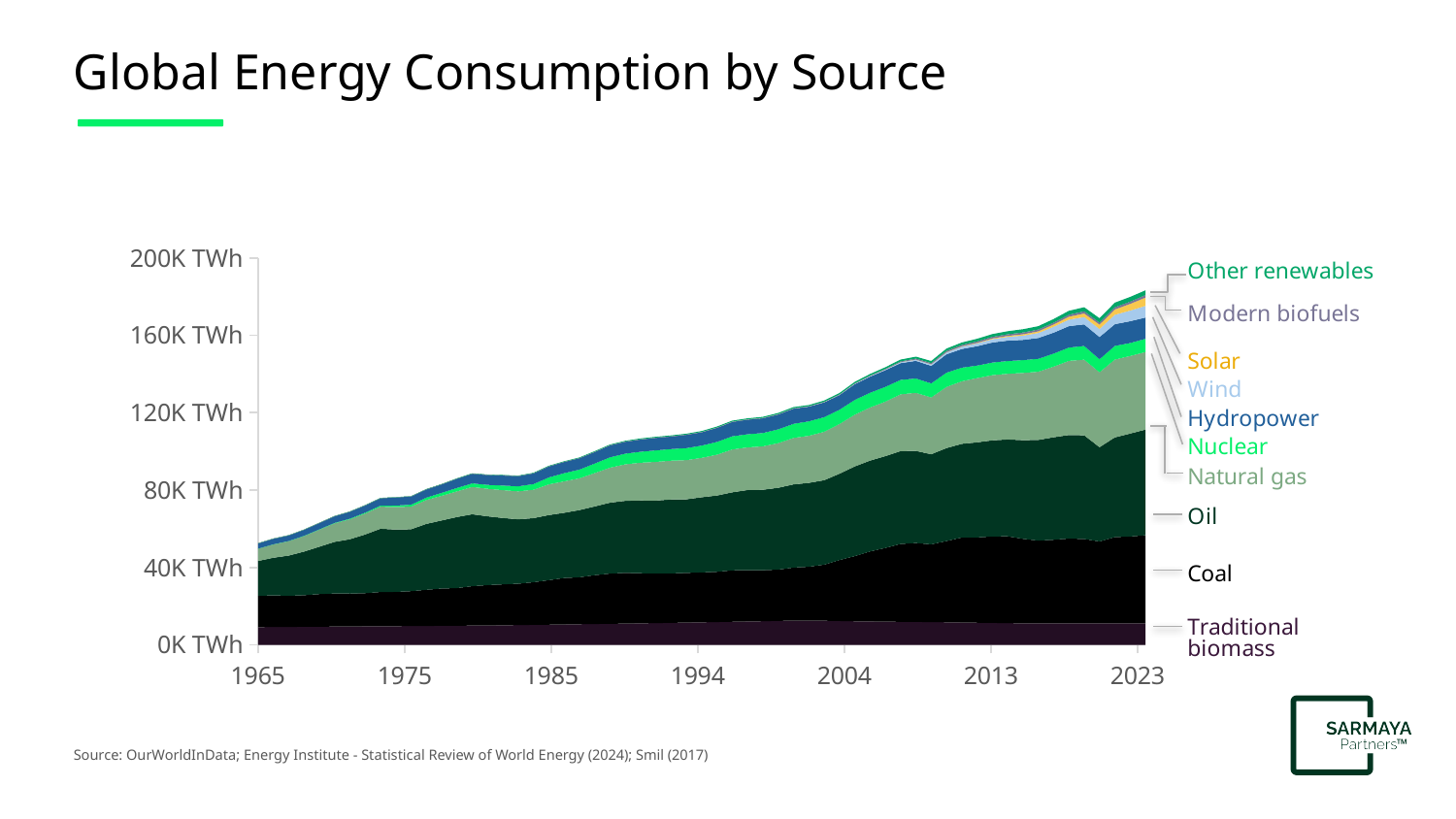
How many energy sources (series) are labelled on the chart? 10 Does total global energy consumption rise or fall from 1965 to 2023? Rise What is the highest value labelled on the y axis? 200K TWh What is the last year shown on the x axis? 2023 How many year labels are shown on the x axis? 7 What is the first year shown on the x axis? 1965 Which energy source forms the bottom layer of the stacked area chart? Traditional biomass Is the total energy consumption in 2023 greater or less than 160K TWh? greater What kind of chart is shown on the slide? Stacked area chart Is the total energy consumption in 2004 greater or less than 100K TWh? greater Is the total energy consumption in 1965 greater or less than 80K TWh? less